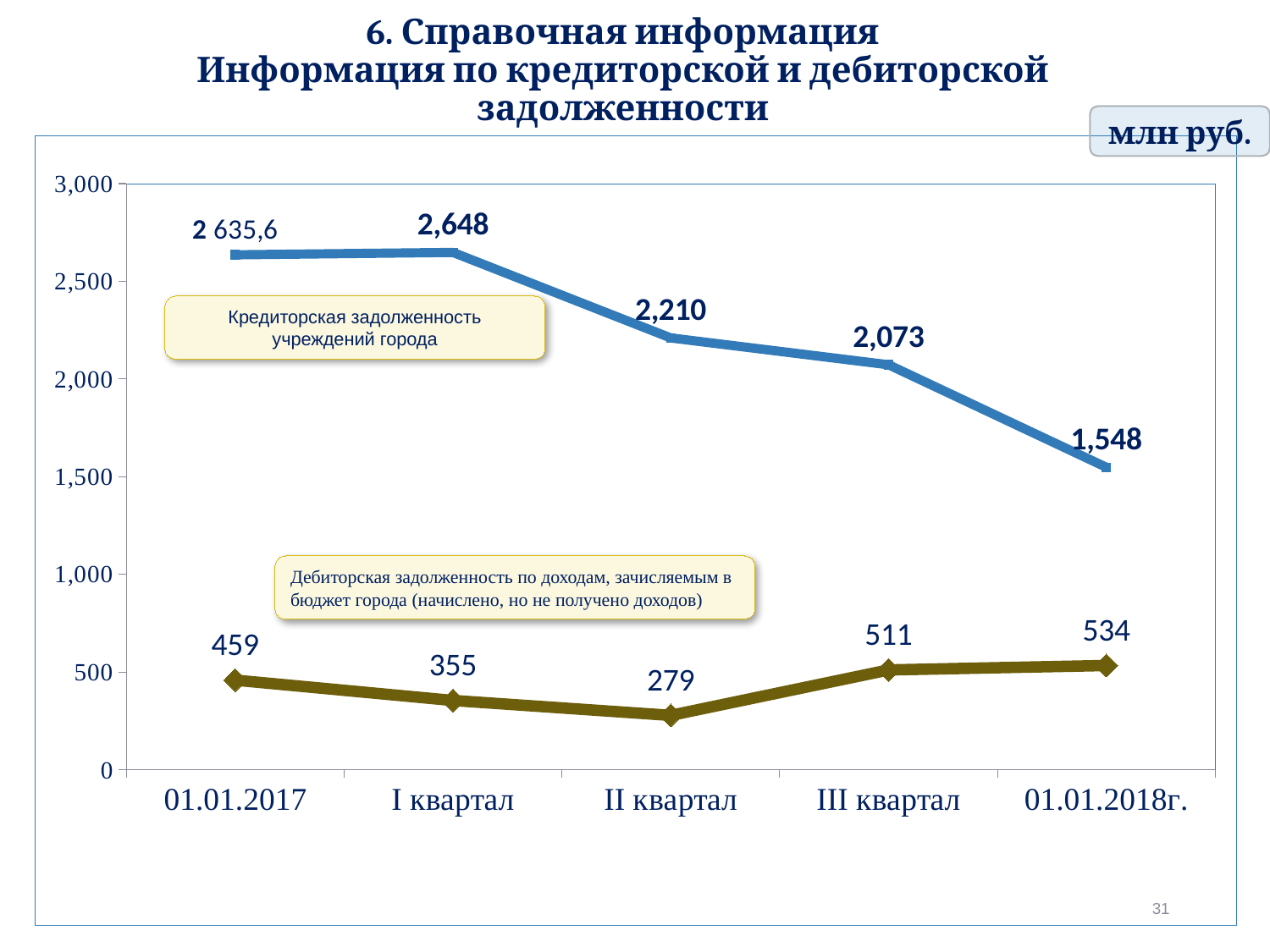
Does Кредиторская задолженность учреждений города rise or fall from I квартал to 01.01.2018г.? fall What type of chart is shown on the slide? line chart What is the difference between Дебиторская задолженность for 01.01.2018г. and III квартал? 23 Which is larger: Дебиторская задолженность for 01.01.2017 or for I квартал? 01.01.2017 What is the value of Кредиторская задолженность учреждений города for II квартал? 2,210 At which point is Кредиторская задолженность учреждений города highest? I квартал What is the value of Дебиторская задолженность for I квартал? 355 What is the value of Дебиторская задолженность for 01.01.2018г.? 534 What is the difference between Кредиторская задолженность for II квартал and III квартал? 137 At which point is Дебиторская задолженность lowest? II квартал What is the value of Кредиторская задолженность учреждений города for 01.01.2018г.? 1,548 How many points are plotted along the x axis? 5